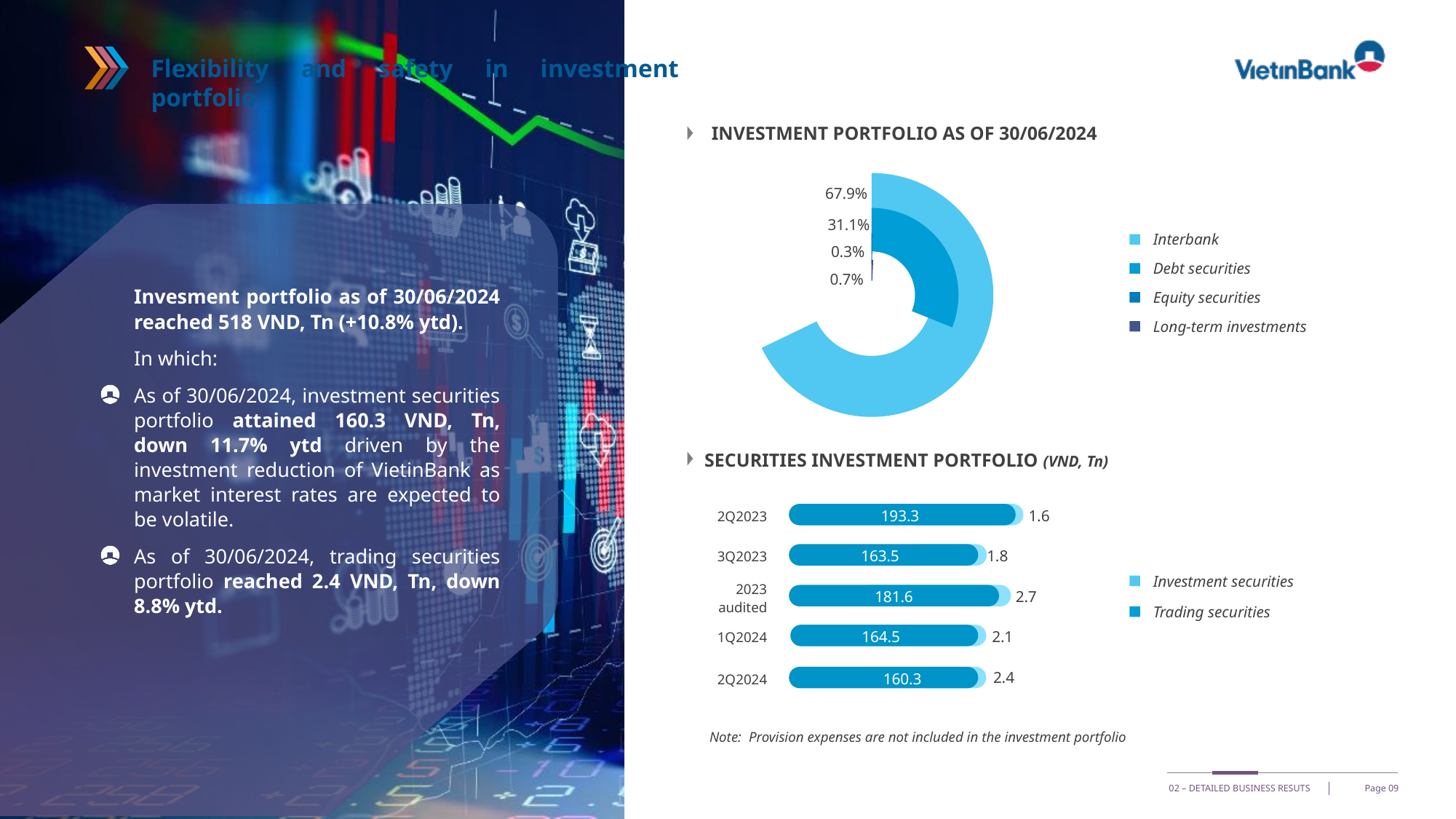
In the 'Securities investment portfolio' chart, which period has the highest Investment securities value? 2Q2023 In the 'Securities investment portfolio' chart, what is the value of Trading securities for 2023 audited? 2.7 In the 'Investment portfolio as of 30/06/2024' chart, what share does Debt securities hold? 31.1% In the 'Securities investment portfolio' chart, which period has the lowest Trading securities value? 2Q2023 In the 'Investment portfolio as of 30/06/2024' chart, which category has the smallest share? Equity securities How many categories does the legend of the 'Investment portfolio as of 30/06/2024' chart list? 4 In the 'Investment portfolio as of 30/06/2024' chart, what share does Interbank hold? 67.9% In the 'Securities investment portfolio' chart, is the Investment securities value for 1Q2024 larger or smaller than for 2023 audited? Smaller In the 'Securities investment portfolio' chart, how many periods are shown? 5 In the 'Securities investment portfolio' chart, what is the value of Investment securities for 2Q2024? 160.3 What kind of chart is the 'Investment portfolio as of 30/06/2024' chart? Donut (pie) chart In the 'Securities investment portfolio' chart, what is the difference in Investment securities between 2Q2023 and 2Q2024? 33.0